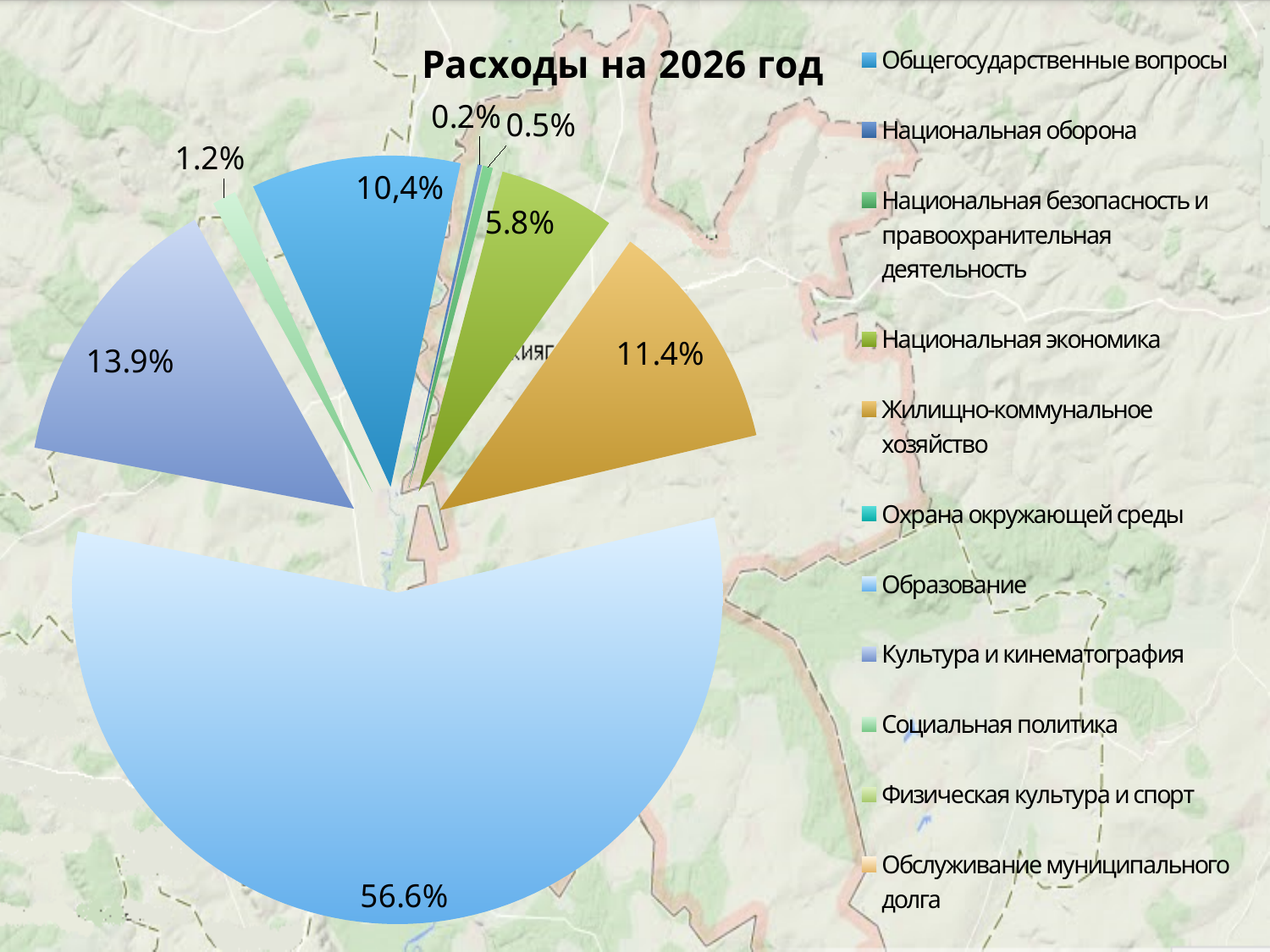
What is the value shown for Общегосударственные вопросы? 10,4% What type of chart is shown on the slide? pie chart What is the value shown for Национальная оборона? 0.2% What is the value shown for Социальная политика? 1.2% How many entries does the legend list? 11 What is the value shown for Национальная экономика? 5.8% What is the value shown for Жилищно-коммунальное хозяйство? 11.4% Which is larger, the share for Культура и кинематография or the share for Жилищно-коммунальное хозяйство? Культура и кинематография What share of the pie does Образование have? 56.6% What is the value shown for Культура и кинематография? 13.9% What is the title of the chart? Расходы на 2026 год Which category has the largest share of the pie? Образование